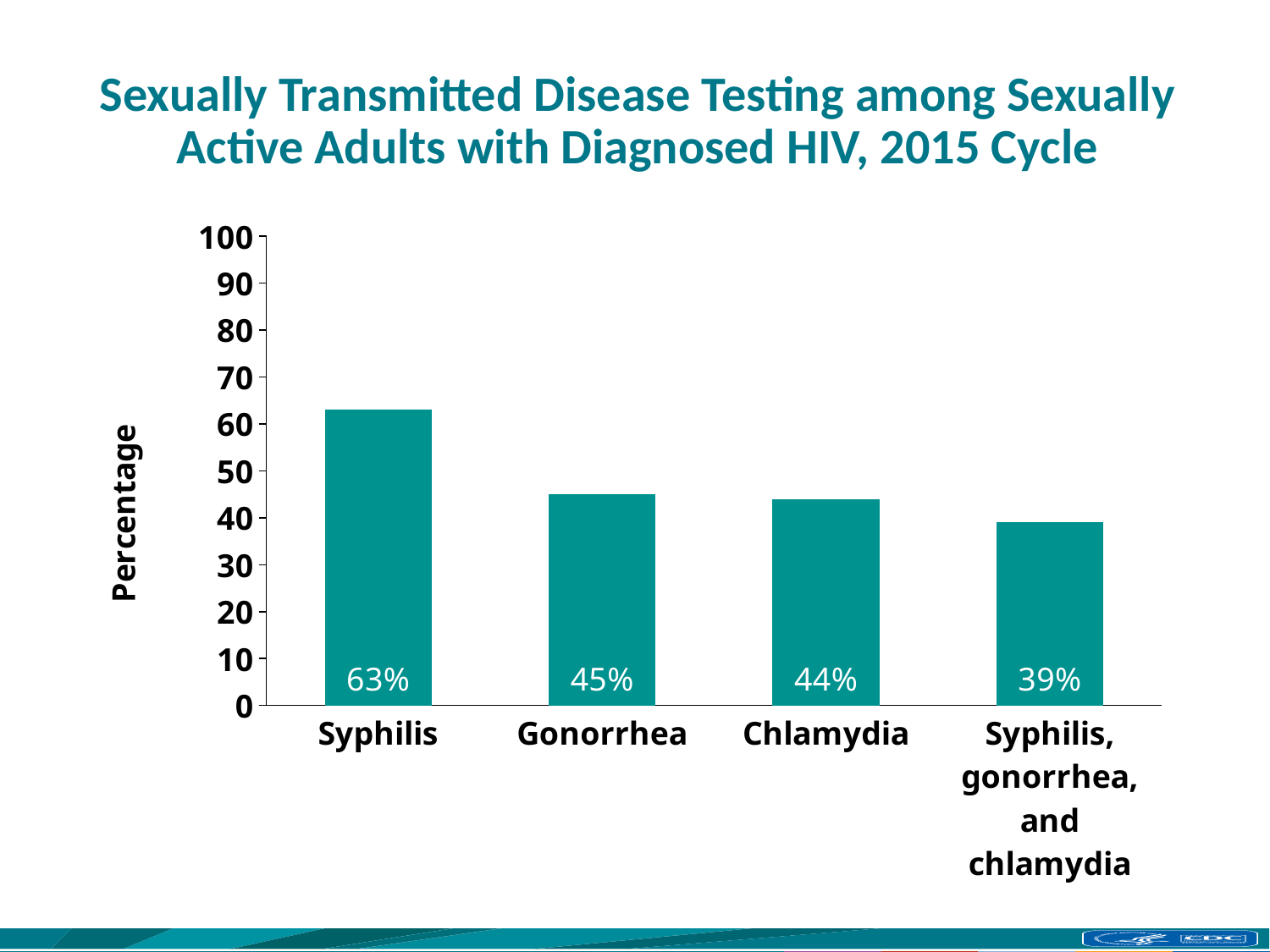
What is the difference in percentage points between Syphilis and Gonorrhea testing? 18 Which category has the lowest percentage? Syphilis, gonorrhea, and chlamydia Which is larger, the value for Syphilis or the value for Chlamydia? Syphilis What percentage were tested for syphilis, gonorrhea, and chlamydia combined? 39% What is the value shown for Chlamydia? 44% What is the difference in percentage points between Chlamydia and the combined Syphilis, gonorrhea, and chlamydia category? 5 Which category has the highest percentage? Syphilis What percentage of sexually active adults with diagnosed HIV were tested for syphilis? 63% What is the value shown for Gonorrhea? 45% How many categories are shown on the x axis? 4 What type of chart is shown on the slide? Bar chart What is the label of the y axis? Percentage